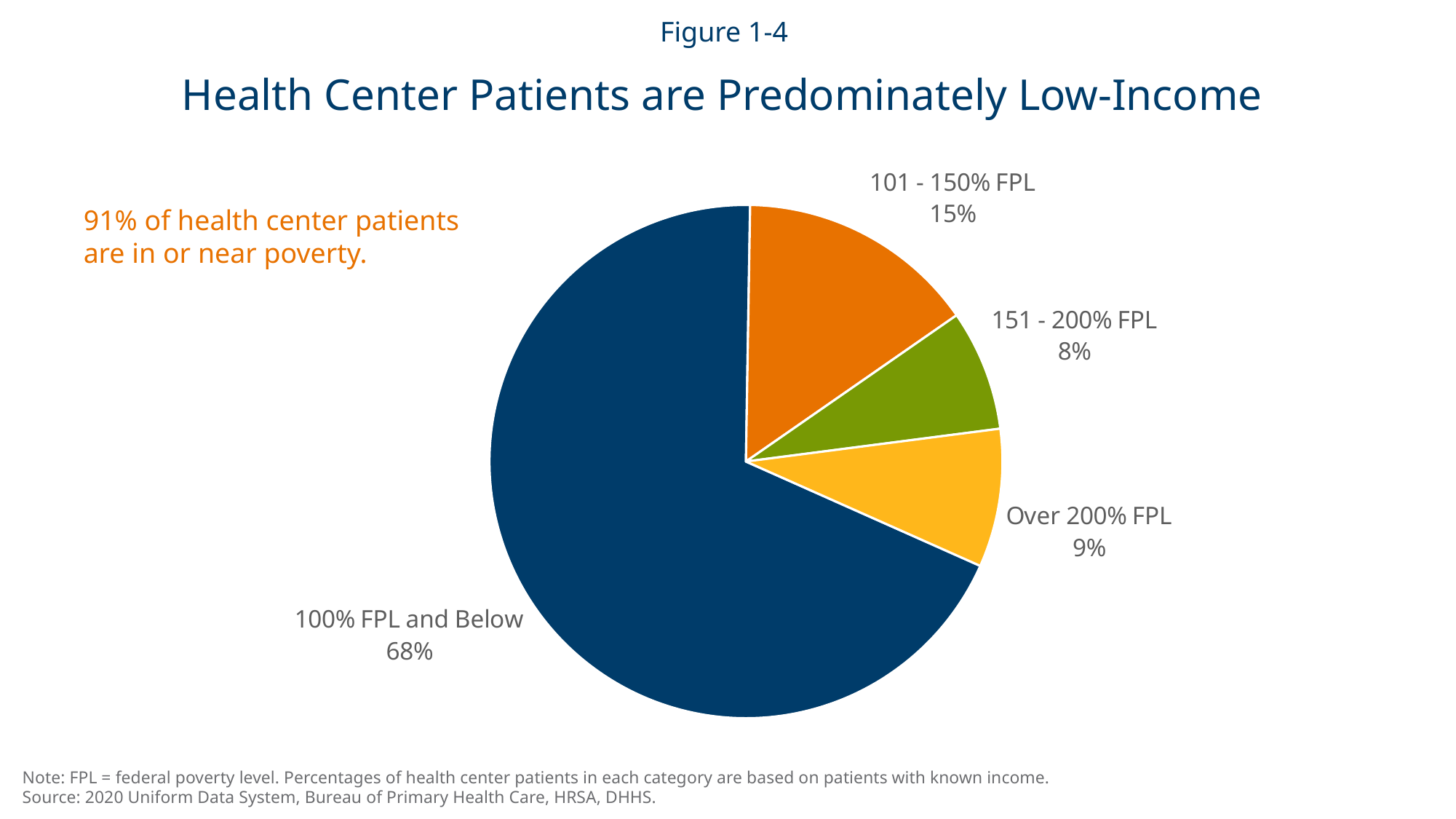
What type of chart is shown on the slide? Pie chart What percentage of health center patients are Over 200% FPL? 9% What colour is the slice for 100% FPL and Below? Dark blue Which category has the largest share of health center patients? 100% FPL and Below What is the difference between the share for 100% FPL and Below and the share for 101 - 150% FPL? 53 percentage points What percentage of health center patients are in the 101 - 150% FPL category? 15% What percentage of health center patients are in the 151 - 200% FPL category? 8% Which category has the smallest share of health center patients? 151 - 200% FPL How many categories are shown in the pie chart? 4 What is the title of the chart? Health Center Patients are Predominately Low-Income What percentage of health center patients are at 100% FPL and Below? 68% Which is larger: the share for Over 200% FPL or the share for 151 - 200% FPL? Over 200% FPL